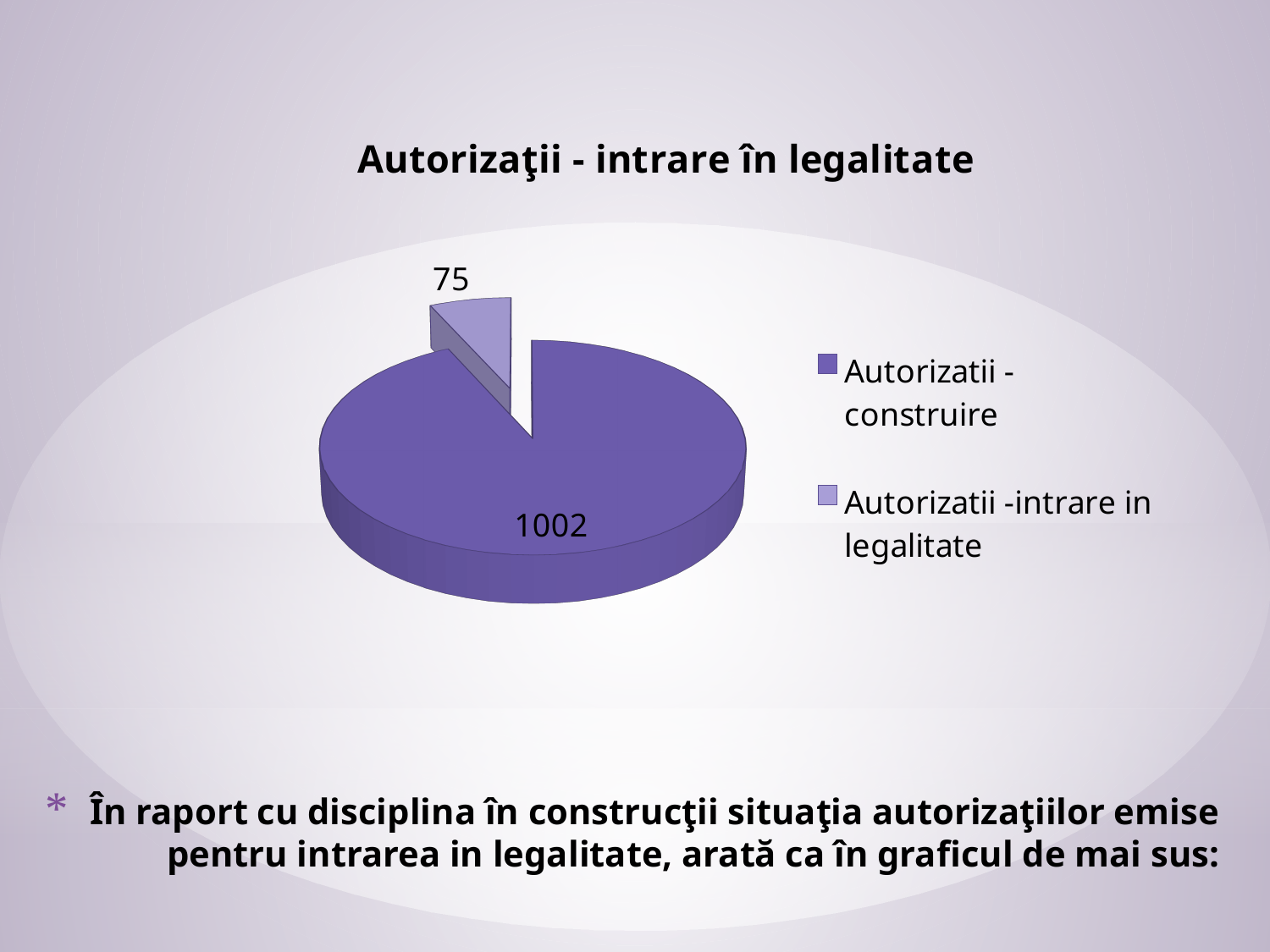
What is the value for Autorizatii -intrare in legalitate? 75 What type of chart is shown on the slide? Pie chart What is the value for Autorizatii - construire? 1002 What is the difference between the values for Autorizatii - construire and Autorizatii -intrare in legalitate? 927 How many slices does the pie chart have? 2 How many entries does the legend list? 2 Which category has the largest slice of the pie? Autorizatii - construire What is the title of the pie chart? Autorizaţii - intrare în legalitate Which is larger, Autorizatii - construire or Autorizatii -intrare in legalitate? Autorizatii - construire Which category has the smallest slice of the pie? Autorizatii -intrare in legalitate What is the total of the two values shown in the pie chart? 1077